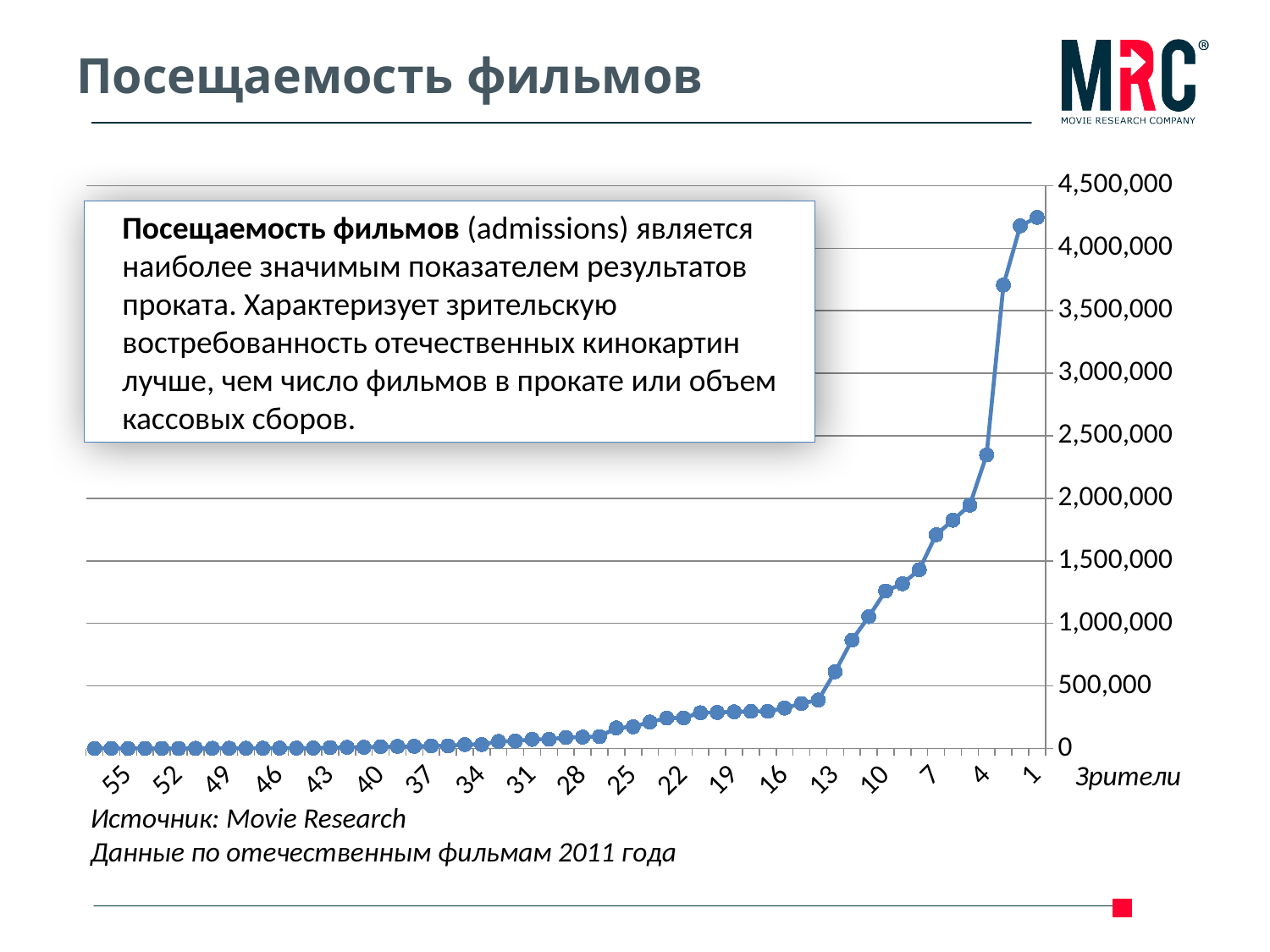
What is the highest tick value shown on the vertical axis? 4,500,000 Which film rank has the highest number of viewers on the chart? 1 Is the value for film rank 55 greater or less than 500,000? less Is the value for film rank 3 greater or less than 3,500,000? greater Is the value for film rank 1 greater or less than 4,000,000? greater What kind of chart is shown on the slide? line chart Do the values rise or fall moving from left (rank 55) to right (rank 1) along the x axis? rise Which has more viewers, film rank 1 or film rank 13? 1